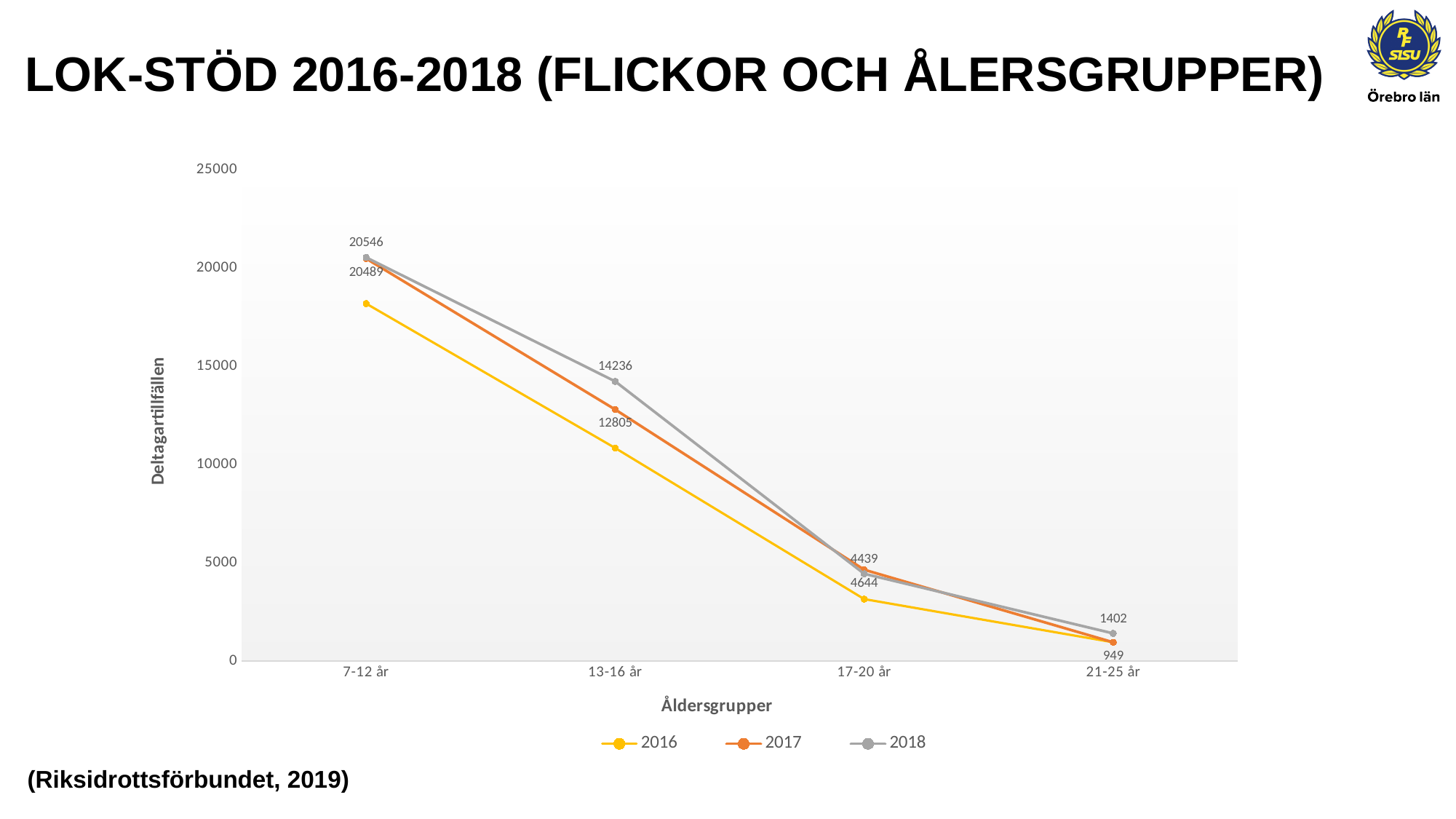
What is the value for 2018 in the 21-25 år age group? 1402 How many age groups are shown on the x axis? 4 What is the difference between the 2018 and 2017 values in the 13-16 år age group? 1431 Which age group has the highest value for the 2018 series? 7-12 år Which age group has the lowest value for the 2017 series? 21-25 år What type of chart is shown on the slide? line chart What is the value for 2018 in the 7-12 år age group? 20546 Do the values for the 2018 series rise or fall from 7-12 år to 21-25 år? fall How many series does the legend list? 3 Is the value for 2016 in the 7-12 år age group greater or less than 20000? less What is the value for 2017 in the 17-20 år age group? 4644 What is the value for 2017 in the 13-16 år age group? 12805